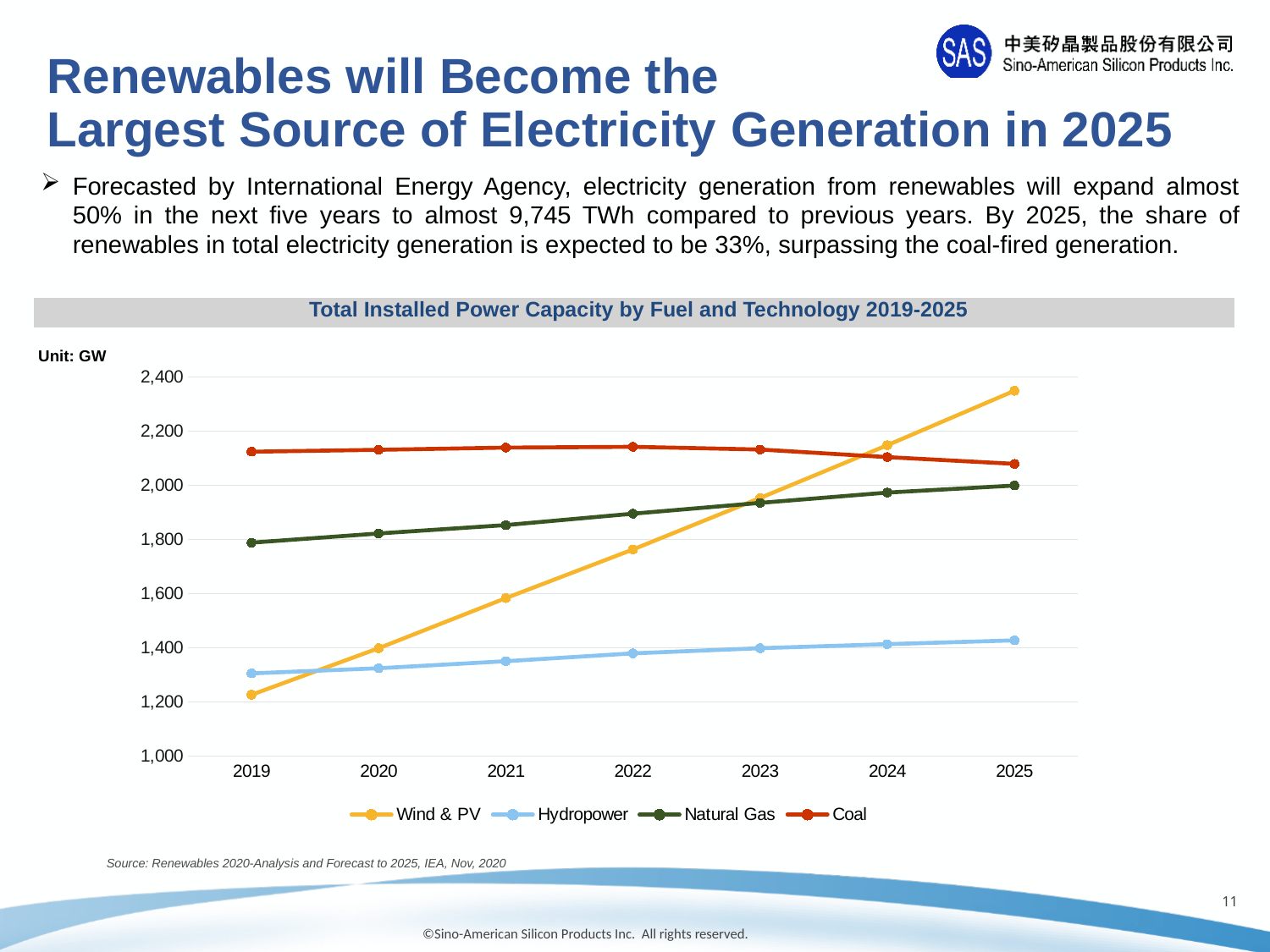
Which series has the lowest value in 2019? Wind & PV What unit is the chart's data given in? GW How many years are plotted along the x axis? 7 Which series has the highest value in 2025? Wind & PV Is the value for Natural Gas in 2022 greater or less than 1,800? greater How many series does the legend list? 4 What kind of chart is shown on the slide? Line chart Does the Wind & PV line rise or fall from 2019 to 2025? Rises Which series has the lowest value in 2025? Hydropower Is the value for Coal in 2025 greater or less than 2,200? less Which series has the highest value in 2019? Coal Is the value for Wind & PV in 2025 greater or less than 2,200? greater